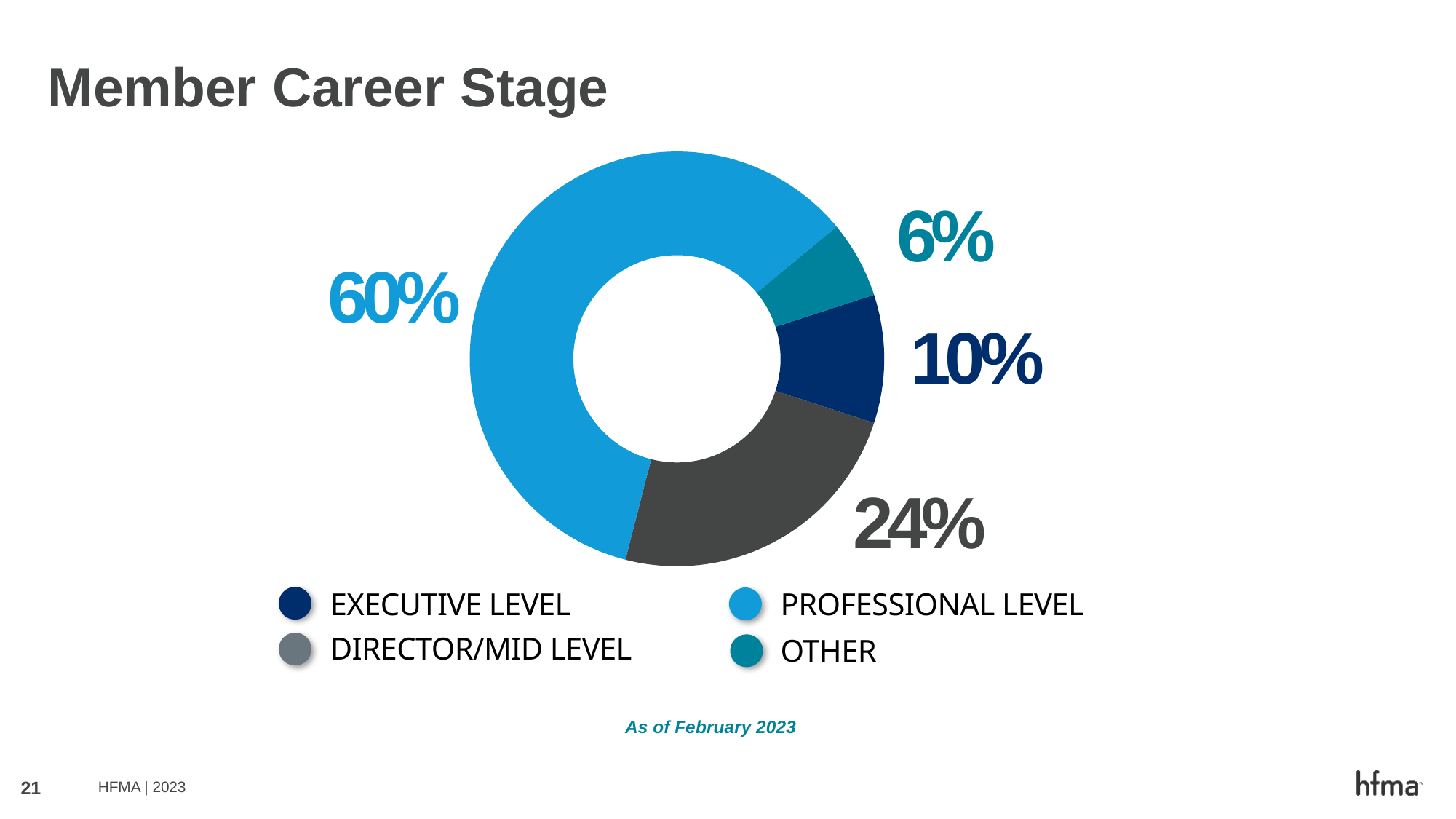
What kind of chart is used to show member career stage? Pie chart (donut) What is the difference in percentage points between the Executive Level and Other shares? 4 What is the difference in percentage points between the Professional Level and Director/Mid Level shares? 36 How many career stage categories are shown in the chart? 4 Which career stage has the smallest share of members? Other Which career stage has the largest share of members? Professional Level What is the title of the slide containing the chart? Member Career Stage What percentage of members fall into the Other category? 6% Which is larger, the Executive Level share or the Director/Mid Level share? Director/Mid Level What percentage of members are at the Executive Level? 10% What percentage of members are at the Professional Level? 60% What percentage of members are at the Director/Mid Level? 24%